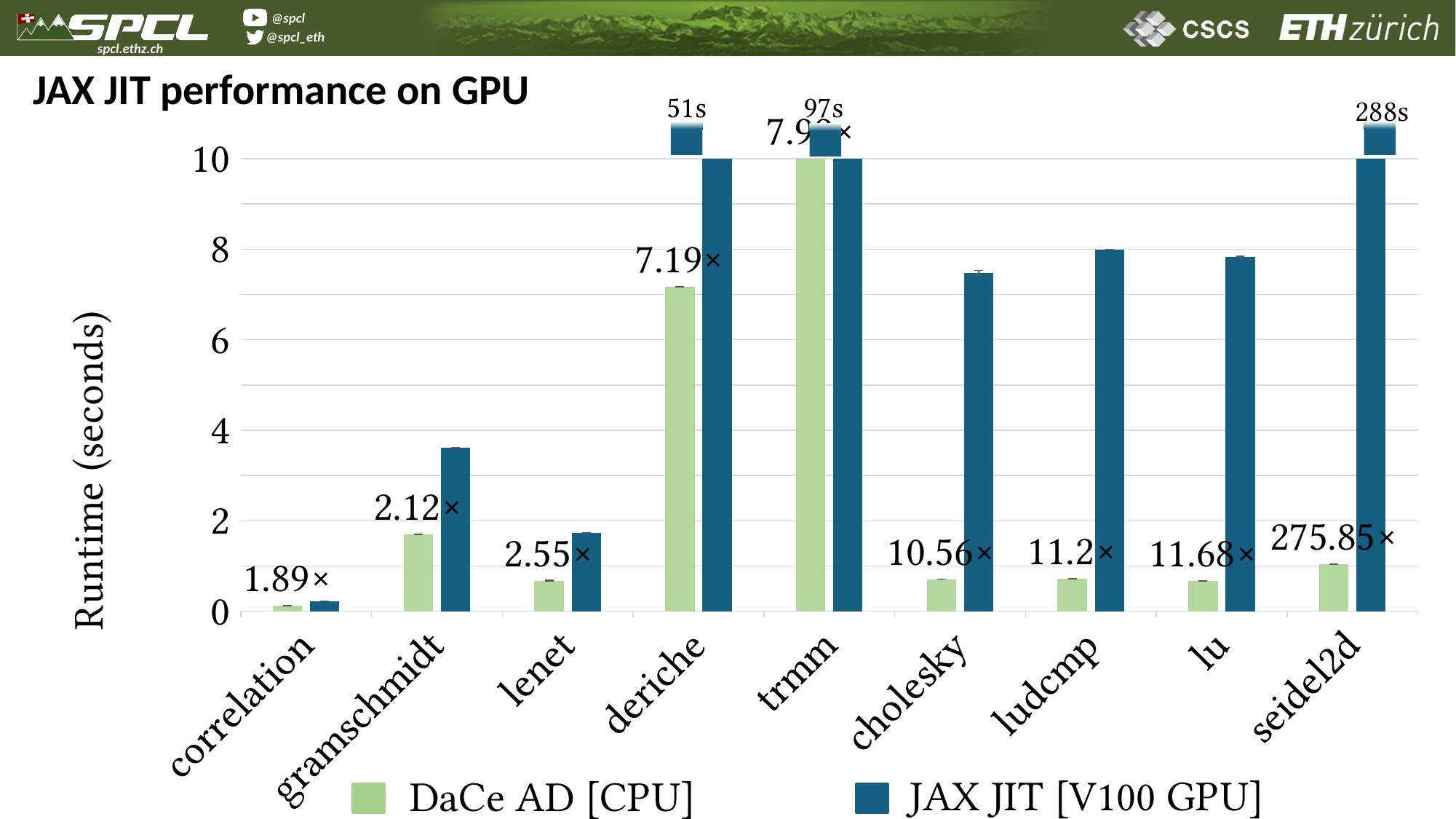
Which category has the lowest JAX JIT [V100 GPU] runtime? correlation What kind of chart is shown on the slide? bar chart Is the JAX JIT [V100 GPU] runtime for gramschmidt greater or less than 4 seconds? less For ludcmp, which series has the larger runtime, DaCe AD [CPU] or JAX JIT [V100 GPU]? JAX JIT [V100 GPU] What runtime is printed above the clipped JAX JIT [V100 GPU] bar for trmm? 97s How many series does the legend list? 2 How many benchmark categories are shown on the x axis? 9 What runtime is printed above the clipped JAX JIT [V100 GPU] bar for seidel2d? 288s Which category has the highest JAX JIT [V100 GPU] runtime? seidel2d What speedup factor is printed above the bars for cholesky? 10.56× What speedup factor is printed above the bars for seidel2d? 275.85× What runtime is printed above the clipped JAX JIT [V100 GPU] bar for deriche? 51s